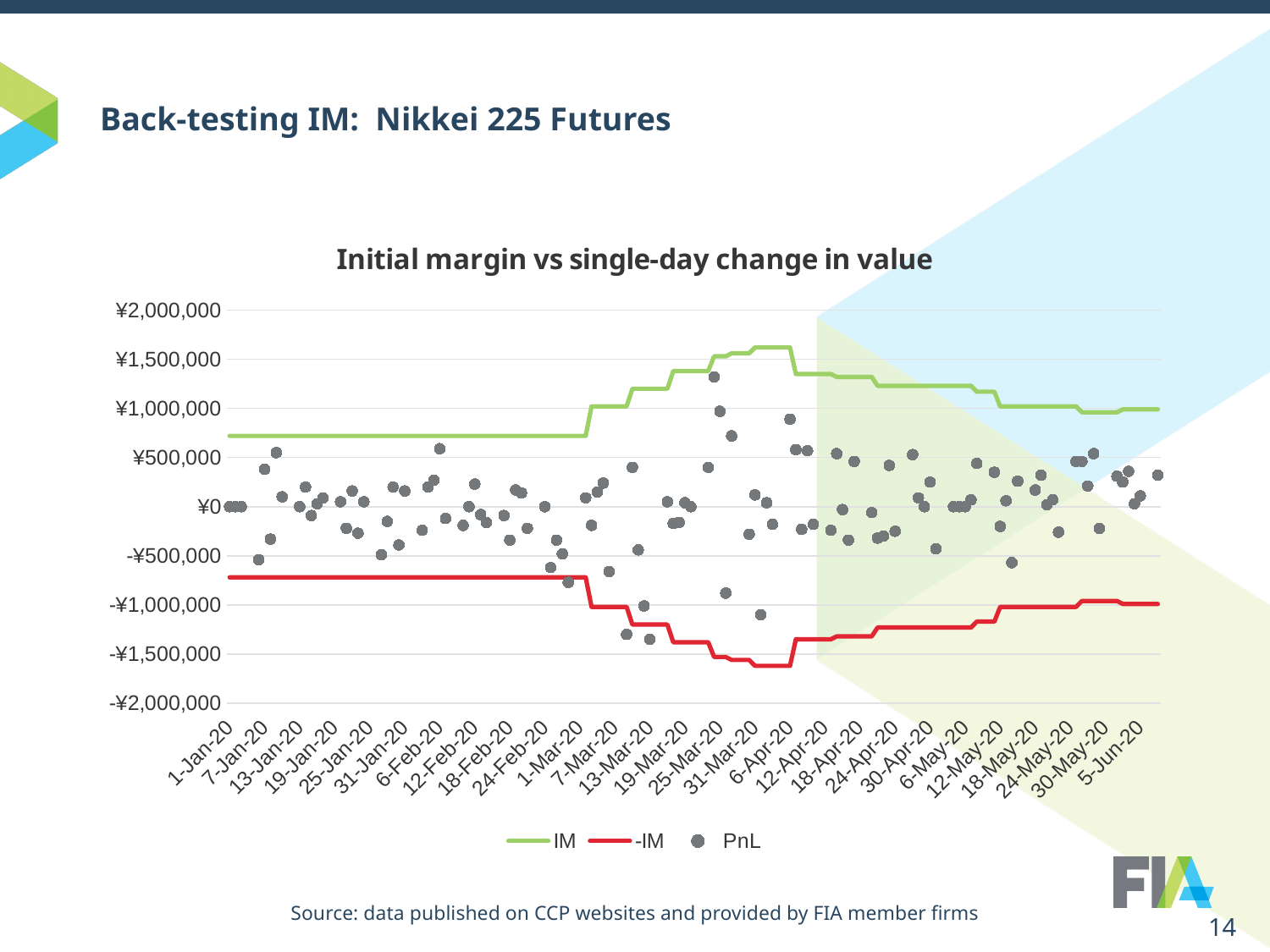
Which series is plotted as grey dots? PnL Is the IM line higher on 1-Jan-20 or on 5-Jun-20? 5-Jun-20 Is the -IM value on 1-Jan-20 greater or less than -¥500,000? less Is the -IM value on 5-Jun-20 greater or less than -¥500,000? less What is the title of the chart? Initial margin vs single-day change in value Is the IM value on 1-Jan-20 greater or less than ¥1,000,000? less Is the IM line higher on 1-Mar-20 or on 6-Apr-20? 6-Apr-20 How many series does the chart legend list? 3 What kind of chart is shown on the slide? Line chart with scatter points Does the IM line rise or fall between 24-Feb-20 and 31-Mar-20? rise What is the highest value shown on the vertical axis? ¥2,000,000